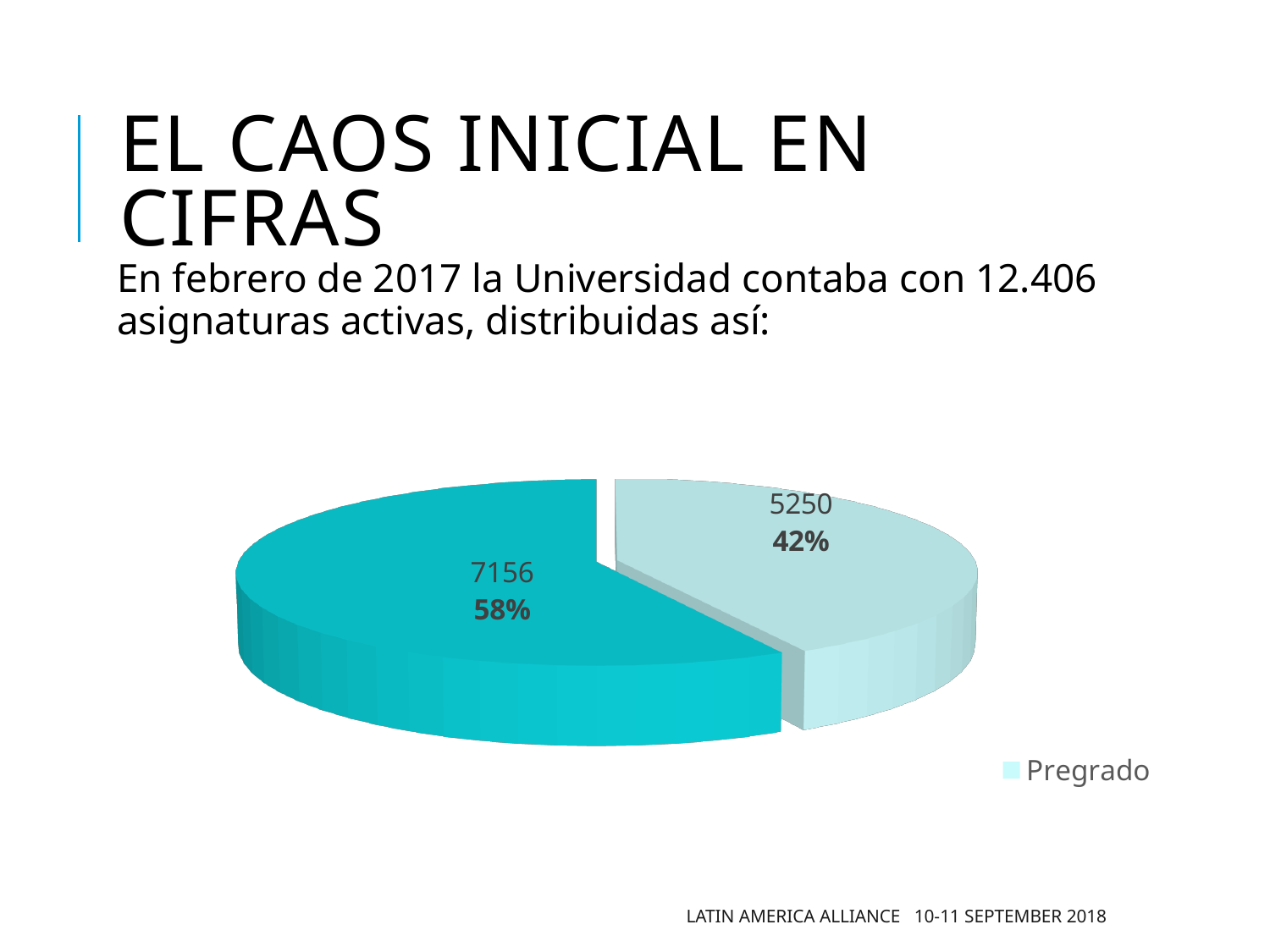
How many slices does the pie chart have? 2 Which category name appears in the legend of the pie chart? Pregrado What value is shown on the larger, darker teal slice of the pie chart? 7156 What value is shown for the Pregrado slice of the pie chart? 5250 Is the value for the Pregrado slice greater or less than 6000? less What is the difference between the two slice values shown on the pie chart (7156 and 5250)? 1906 What is the total of the two slice values shown on the pie chart? 12406 What kind of chart is shown on the slide? pie chart What percentage share of the pie does the larger, darker teal slice represent? 58% Which slice is larger: the Pregrado slice or the darker teal slice? the darker teal slice How many entries does the legend of the pie chart list? 1 What percentage share of the pie does the Pregrado slice represent? 42%